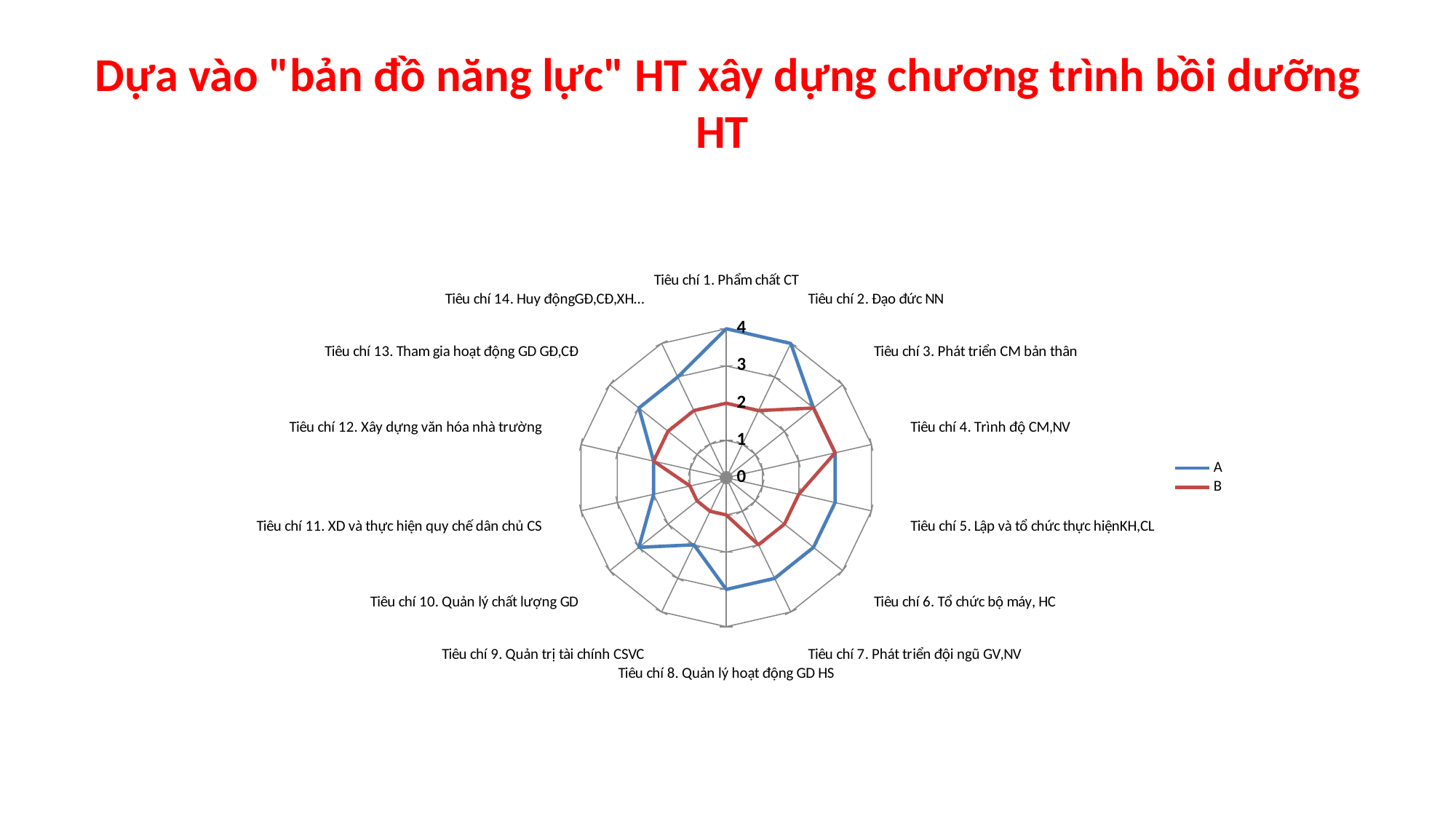
What is the value of series B for Tiêu chí 1. Phẩm chất CT? 2 Which series has the larger value for Tiêu chí 8. Quản lý hoạt động GD HS, A or B? A Which series generally has the larger values across the criteria, A or B? A What are the names of the series in the legend? A and B What is the value of series A for Tiêu chí 1. Phẩm chất CT? 4 What kind of chart is shown on the slide? Radar chart Which series has the larger value for Tiêu chí 1. Phẩm chất CT, A or B? A How many series does the legend list? 2 Is the value of series B for Tiêu chí 2. Đạo đức NN greater or less than 3? less How many criteria (categories) are plotted on the radar chart? 14 What is the maximum value shown on the radar chart's axis scale? 4